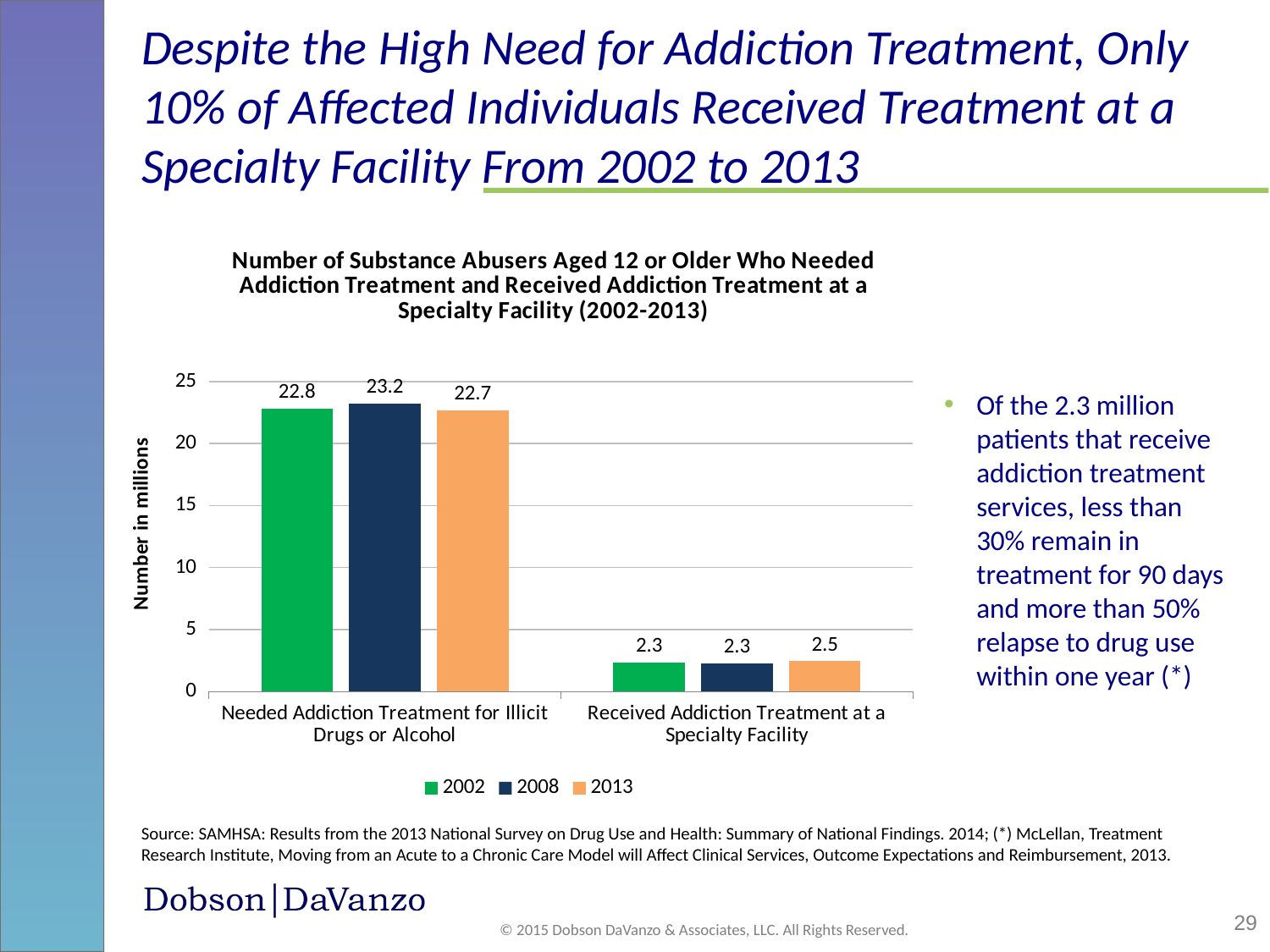
Which year has the lowest value in the 'Needed Addiction Treatment for Illicit Drugs or Alcohol' category? 2013 Which year has the highest value in the 'Needed Addiction Treatment for Illicit Drugs or Alcohol' category? 2008 What is the value for 2013 in the 'Received Addiction Treatment at a Specialty Facility' category? 2.5 What is the difference between the 2008 and 2013 values in the 'Needed Addiction Treatment for Illicit Drugs or Alcohol' category? 0.5 How many categories are shown on the x axis? 2 Which is larger: the 2013 value for 'Received Addiction Treatment at a Specialty Facility' or the 2002 value for the same category? 2013 What kind of chart is shown on the slide? Bar chart What is the difference between the 2013 values for 'Needed Addiction Treatment for Illicit Drugs or Alcohol' and 'Received Addiction Treatment at a Specialty Facility'? 20.2 How many series does the legend list? 3 Is the 2002 value for 'Received Addiction Treatment at a Specialty Facility' greater or less than 5? less What is the value for 2008 in the 'Needed Addiction Treatment for Illicit Drugs or Alcohol' category? 23.2 What is the value for 2002 in the 'Needed Addiction Treatment for Illicit Drugs or Alcohol' category? 22.8